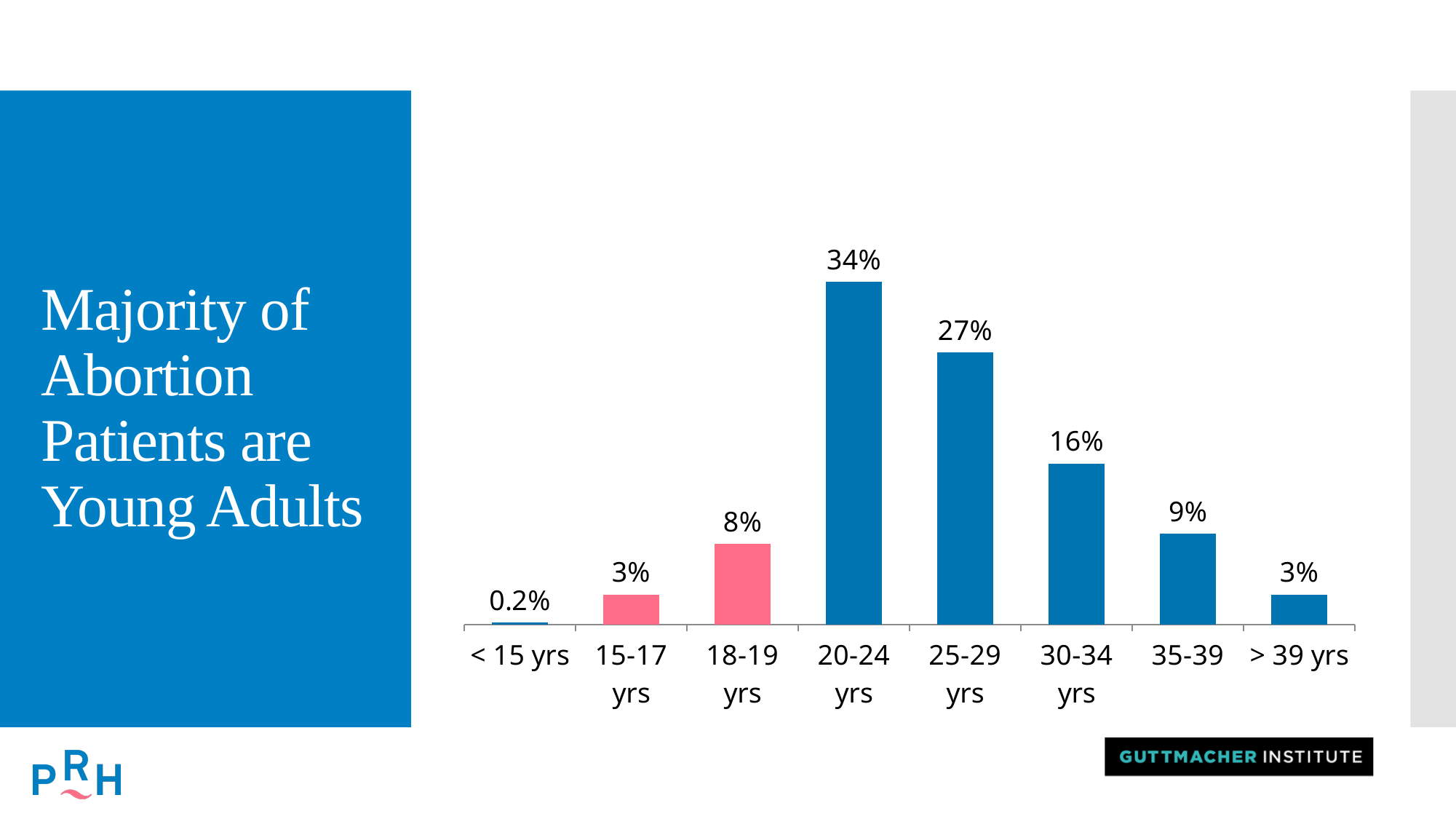
What is the value for the < 15 yrs age group? 0.2% How many age groups are shown on the chart? 8 What is the difference between the values for 30-34 yrs and 35-39 yrs? 7% What kind of chart is shown on the slide? Bar chart Which age group has the highest value? 20-24 yrs Which is larger, the value for 18-19 yrs or the value for 35-39 yrs? 35-39 yrs Which age groups are shown with pink bars? 15-17 yrs and 18-19 yrs What is the value for the 30-34 yrs age group? 16% Which age group has the lowest value? < 15 yrs What is the difference between the values for 20-24 yrs and 25-29 yrs? 7% What is the value for the 20-24 yrs age group? 34% What is the value for the 18-19 yrs age group? 8%